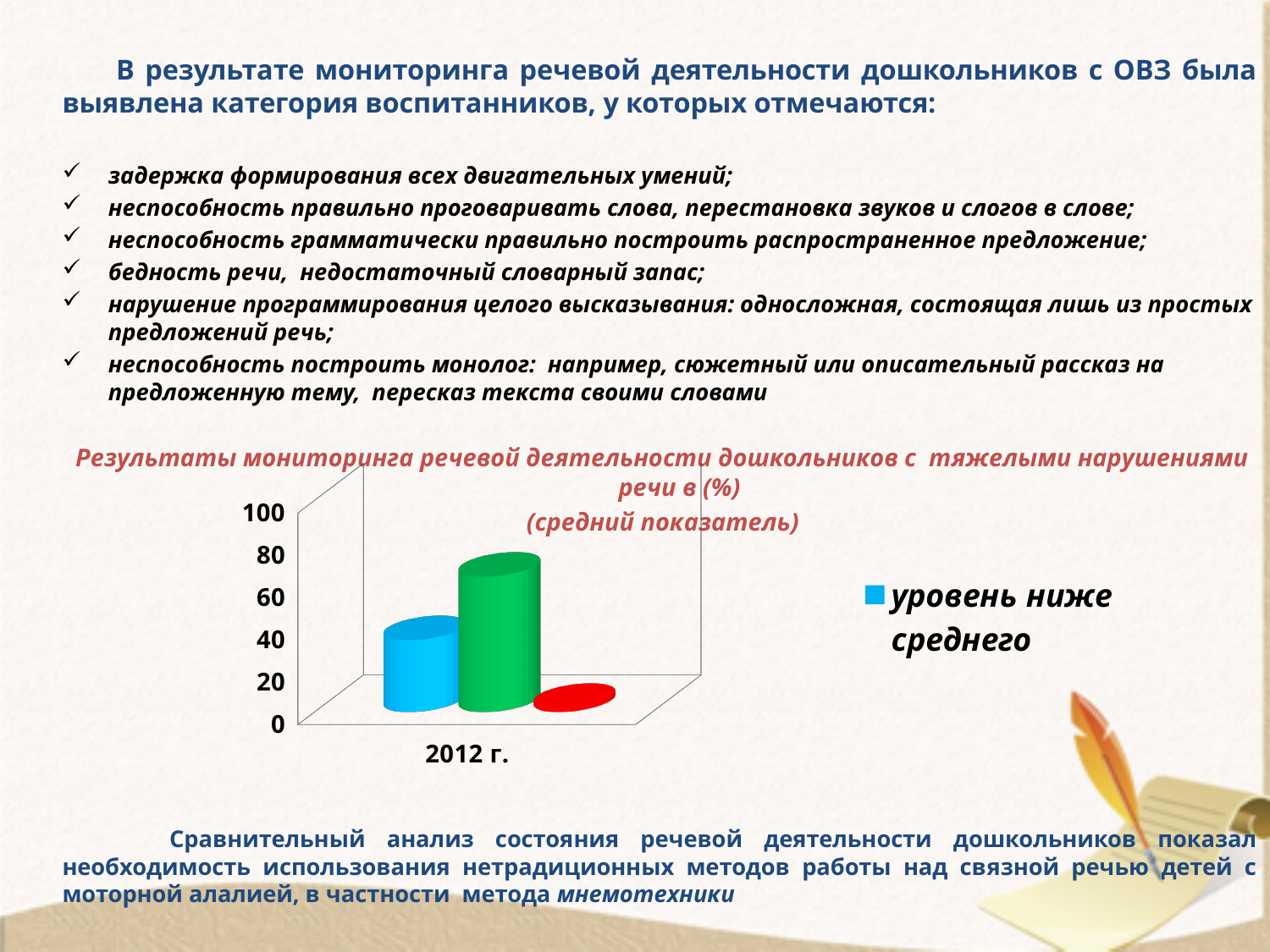
How many categories are shown on the x axis of the chart? 1 Which is larger, the blue bar ('уровень ниже среднего') or the green bar? the green bar What kind of chart is shown on the slide? bar chart Is the value of the red bar greater or less than 20? less Is the value of the green bar greater or less than 40? greater How many series does the chart's legend list? 1 Which bar is the tallest in the chart: the blue, green or red one? green Is the value for 'уровень ниже среднего' (the blue bar) greater or less than 60? less Which bar is the shortest in the chart: the blue, green or red one? red What is the category label on the x axis of the chart? 2012 г. What is the title of the chart? Результаты мониторинга речевой деятельности дошкольников с тяжелыми нарушениями речи в (%) (средний показатель)